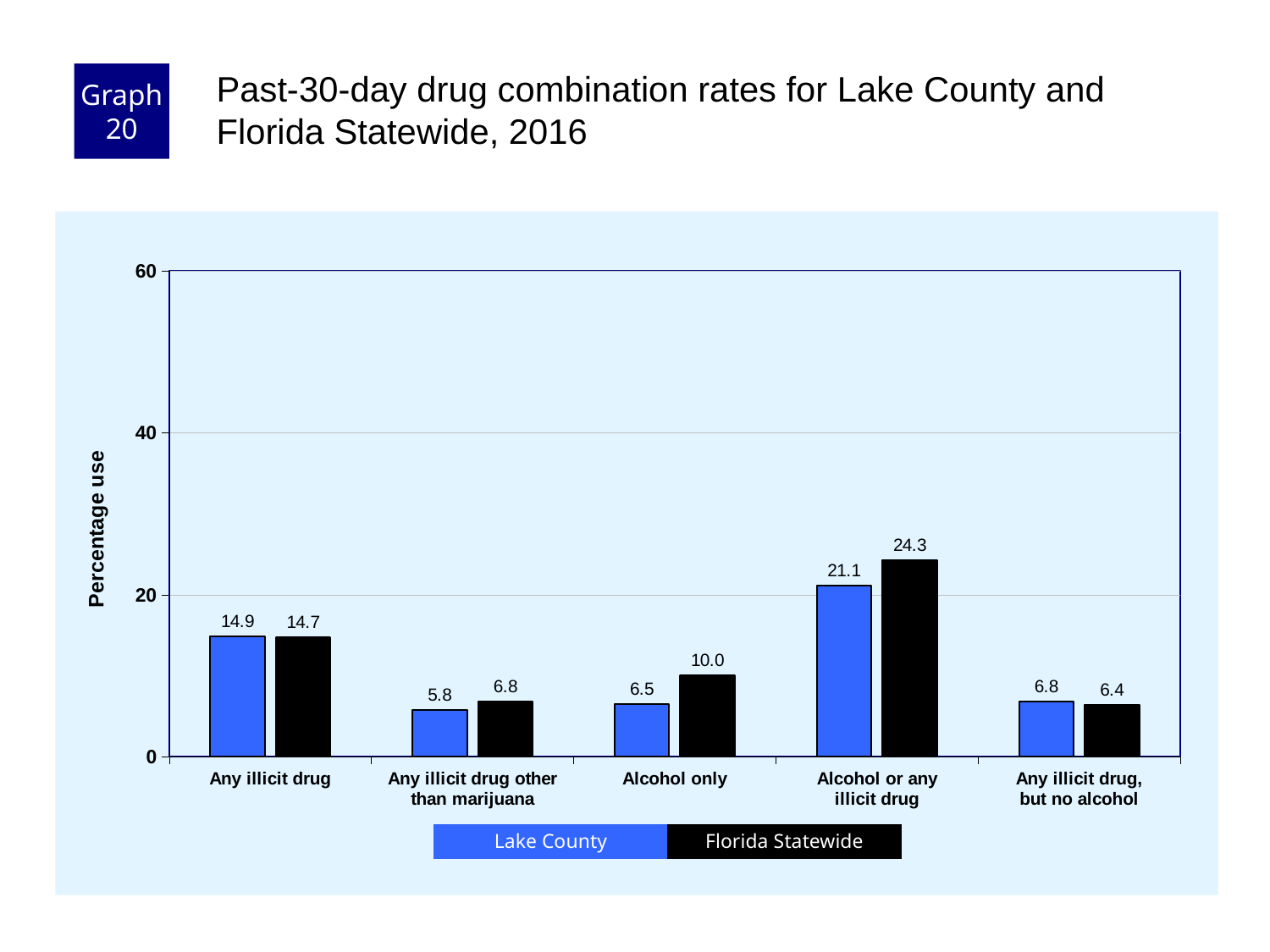
What kind of chart is shown on the slide? bar chart How many categories are shown on the x axis? 5 For Alcohol only, which is larger: Lake County or Florida Statewide? Florida Statewide How many series does the legend list? 2 Which category has the lowest Florida Statewide value? Any illicit drug, but no alcohol What is the Florida Statewide value for Alcohol only? 10.0 Is the Florida Statewide value for Alcohol or any illicit drug greater or less than 20? greater Which category has the highest Lake County value? Alcohol or any illicit drug What is the Florida Statewide value for Alcohol or any illicit drug? 24.3 What is the difference between the Florida Statewide and Lake County values for Alcohol or any illicit drug? 3.2 What is the label of the y axis? Percentage use What is the Lake County value for Any illicit drug? 14.9